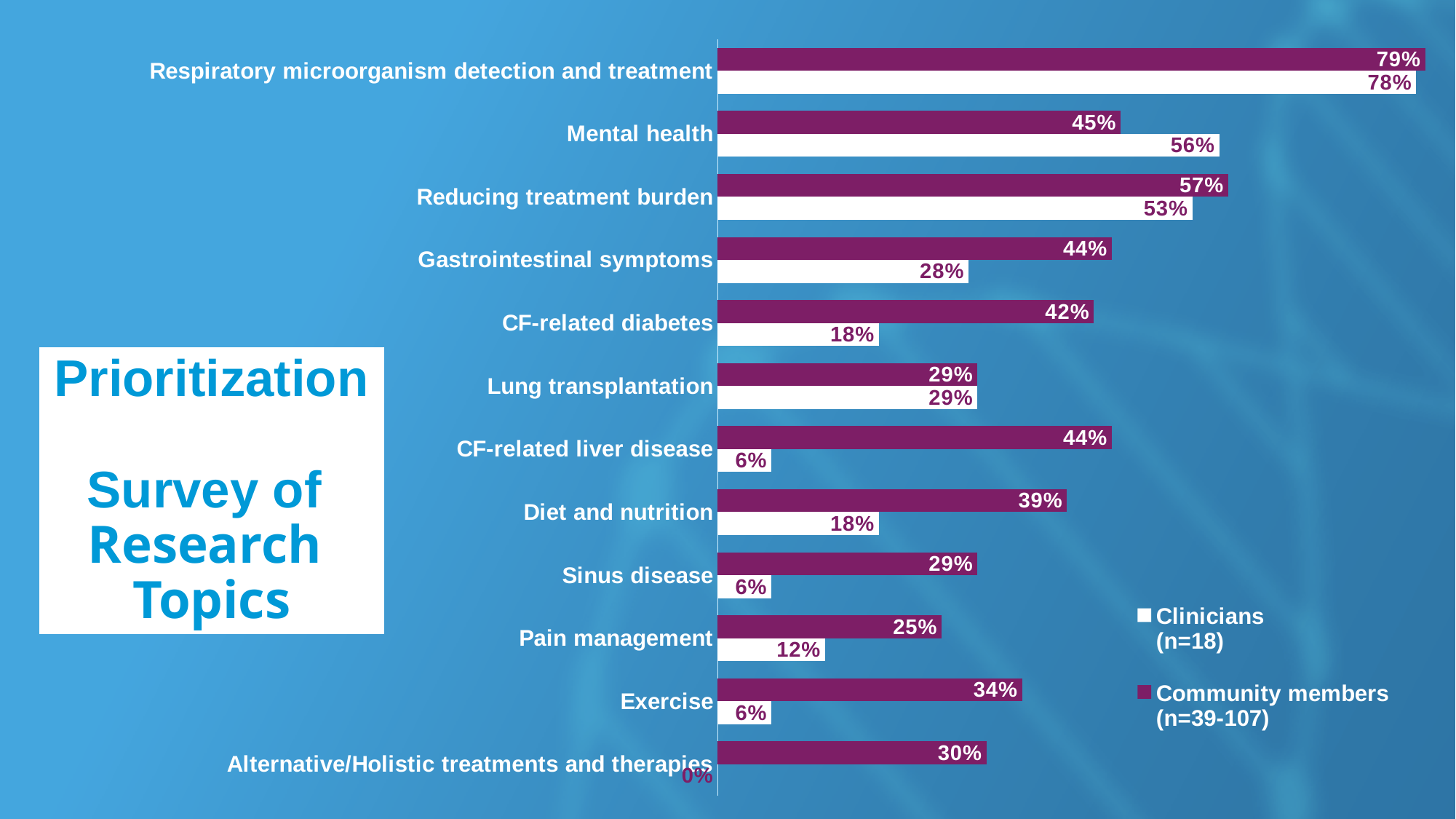
What percentage of clinicians prioritized Mental health? 56% What percentage of community members prioritized Respiratory microorganism detection and treatment? 79% What is the clinicians' value for CF-related diabetes? 18% Which is larger: the community members' value for Reducing treatment burden or for Gastrointestinal symptoms? Reducing treatment burden What type of chart is shown on the slide? Bar chart How many series does the legend list? 2 How many research topics are listed on the chart? 12 What is the difference between the community members' and clinicians' values for CF-related liver disease? 38% Which research topic has the highest value among community members? Respiratory microorganism detection and treatment Which research topic has the lowest value among clinicians? Alternative/Holistic treatments and therapies For Mental health, which group has the larger value, clinicians or community members? Clinicians What sample size is given for clinicians in the legend? n=18